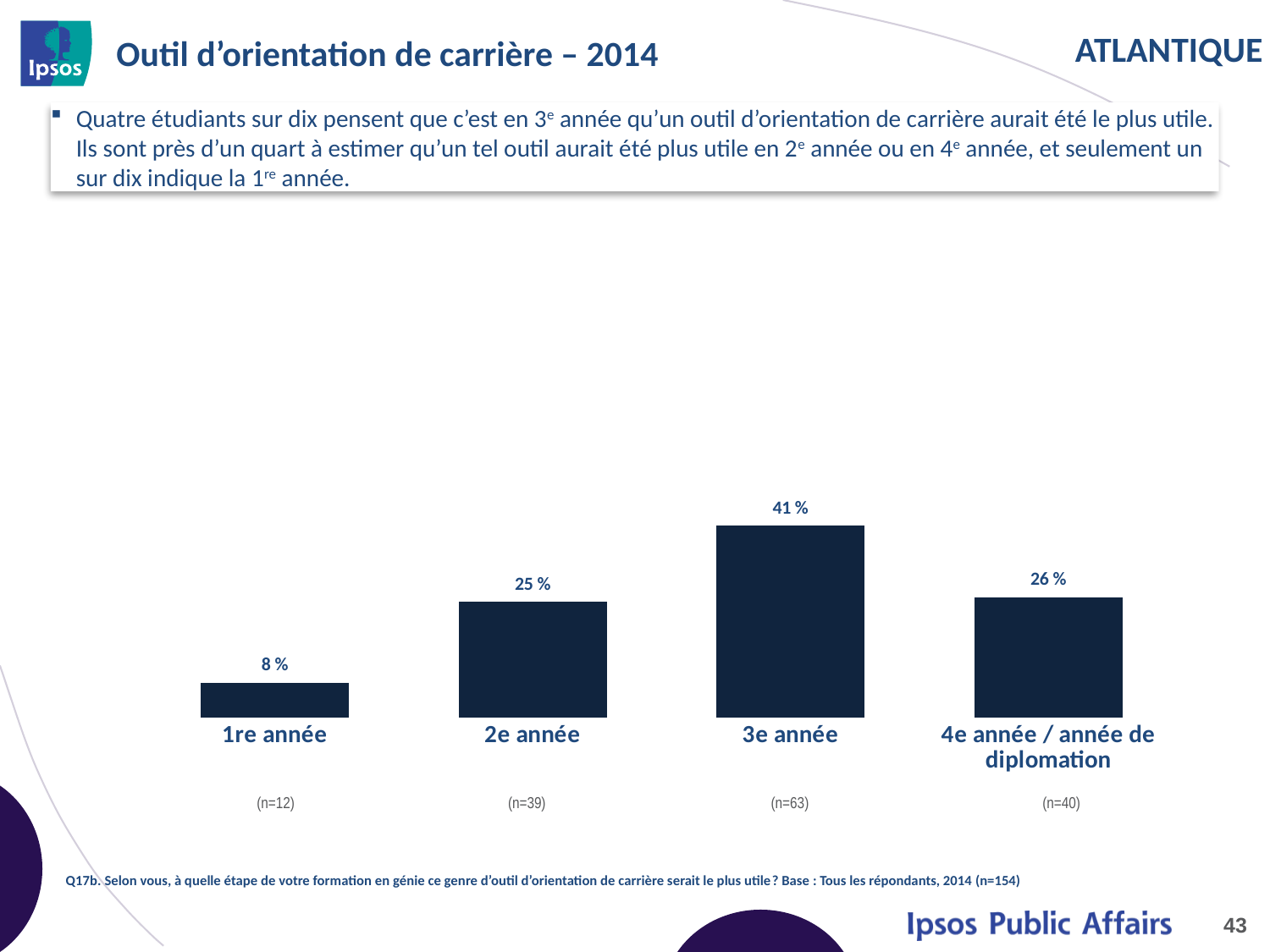
Which category has the highest value? 3e année What is the difference between the values for 3e année and 1re année? 33 % Which category has the lowest value? 1re année How many categories are shown in the chart? 4 Which is larger, the value for 3e année or the value for 2e année? 3e année What is the value for 2e année? 25 % What is the value for 3e année? 41 % What is the value for 1re année? 8 % What is the sample size (n) shown under the 3e année bar? (n=63) What kind of chart is shown on the slide? Bar chart What is the difference between the values for 4e année / année de diplomation and 2e année? 1 % What is the value for 4e année / année de diplomation? 26 %